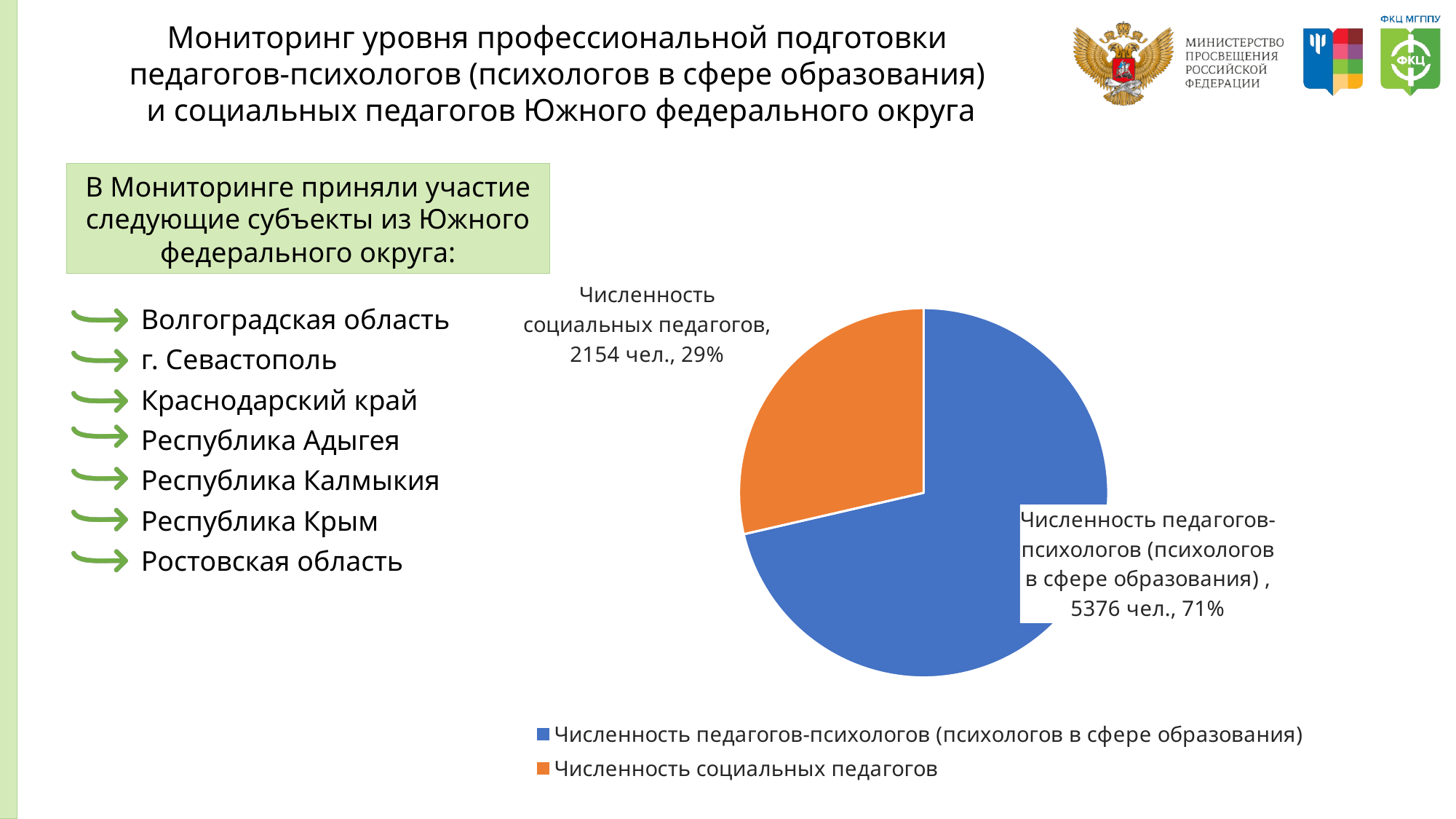
What is the number of people for 'Численность педагогов-психологов (психологов в сфере образования)' in the pie chart? 5376 чел. What share of the pie does 'Численность педагогов-психологов (психологов в сфере образования)' represent? 71% What is the number of people for 'Численность социальных педагогов' in the pie chart? 2154 чел. What colour is the slice for 'Численность социальных педагогов' in the pie chart? orange Which slice of the pie chart is the smallest? Численность социальных педагогов What is the total number of people across both slices of the pie chart? 7530 чел. What share of the pie does 'Численность социальных педагогов' represent? 29% How many entries does the legend of the pie chart list? 2 Which slice of the pie chart is the largest? Численность педагогов-психологов (психологов в сфере образования) How many slices does the pie chart have? 2 What type of chart is shown on the slide? pie chart What is the difference in people between 'Численность педагогов-психологов (психологов в сфере образования)' and 'Численность социальных педагогов'? 3222 чел.